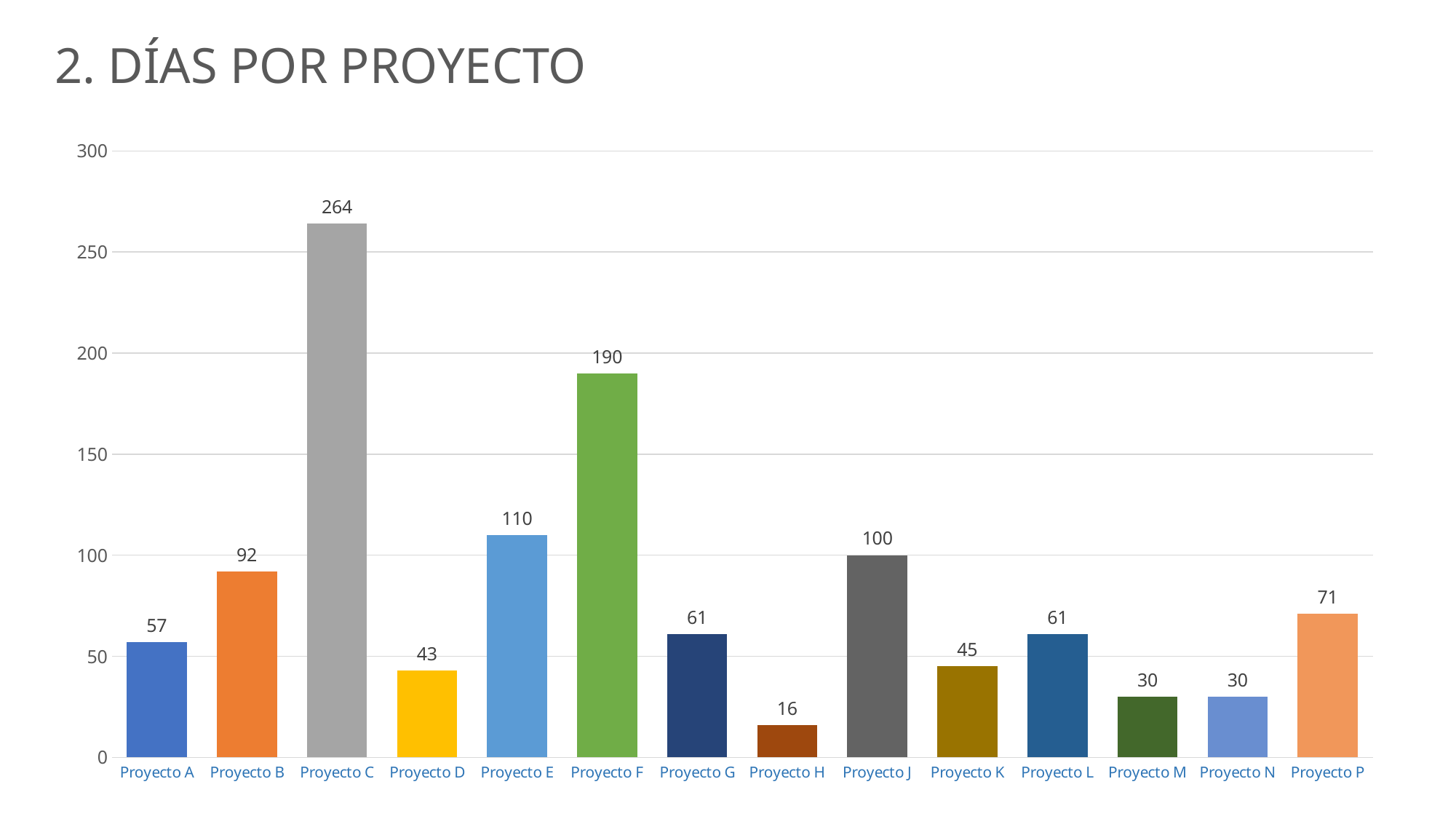
Which is larger, the value for Proyecto B or the value for Proyecto P? Proyecto B What is the value for Proyecto K? 45 How many projects are shown on the chart? 14 What is the title of the slide? 2. DÍAS POR PROYECTO What is the difference between the values for Proyecto E and Proyecto J? 10 What kind of chart is shown on the slide? Bar chart Is the value for Proyecto F greater or less than 150? greater Which project has the highest value? Proyecto C Which project has the lowest value? Proyecto H What is the value for Proyecto C? 264 What is the difference between the values for Proyecto C and Proyecto F? 74 What is the value for Proyecto H? 16